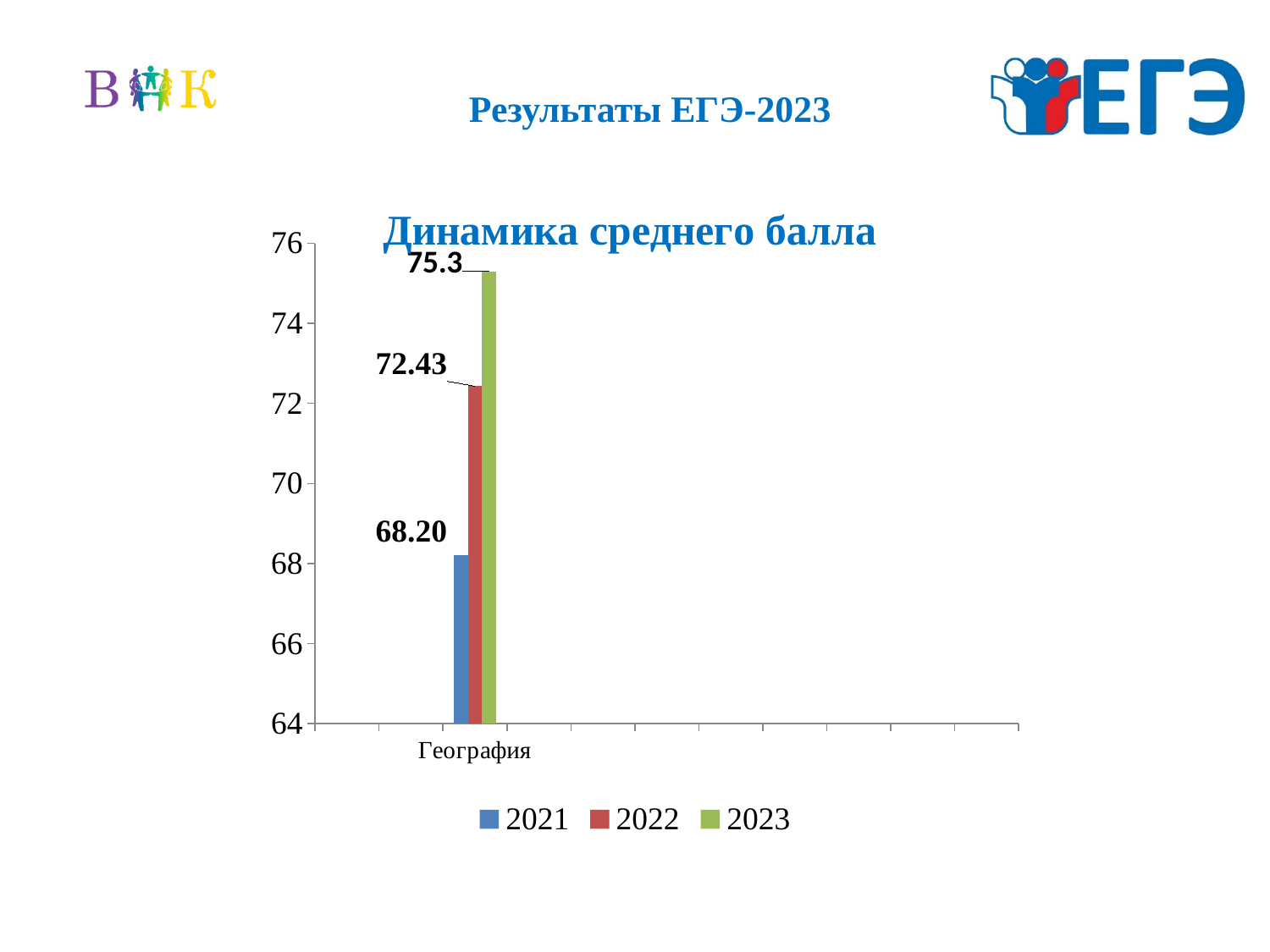
Which year has the lowest value for География? 2021 Which is larger for География, the 2022 value or the 2023 value? 2023 What is the difference between the 2022 and 2021 values for География? 4.23 How many series does the legend list? 3 What kind of chart is shown? bar chart What is the title of the chart? Динамика среднего балла Which year has the highest value for География? 2023 What is the value for 2021 for География? 68.20 Is the value for 2021 greater or less than 70? less What is the difference between the 2023 and 2021 values for География? 7.1 What is the value for 2023 for География? 75.3 What is the value for 2022 for География? 72.43